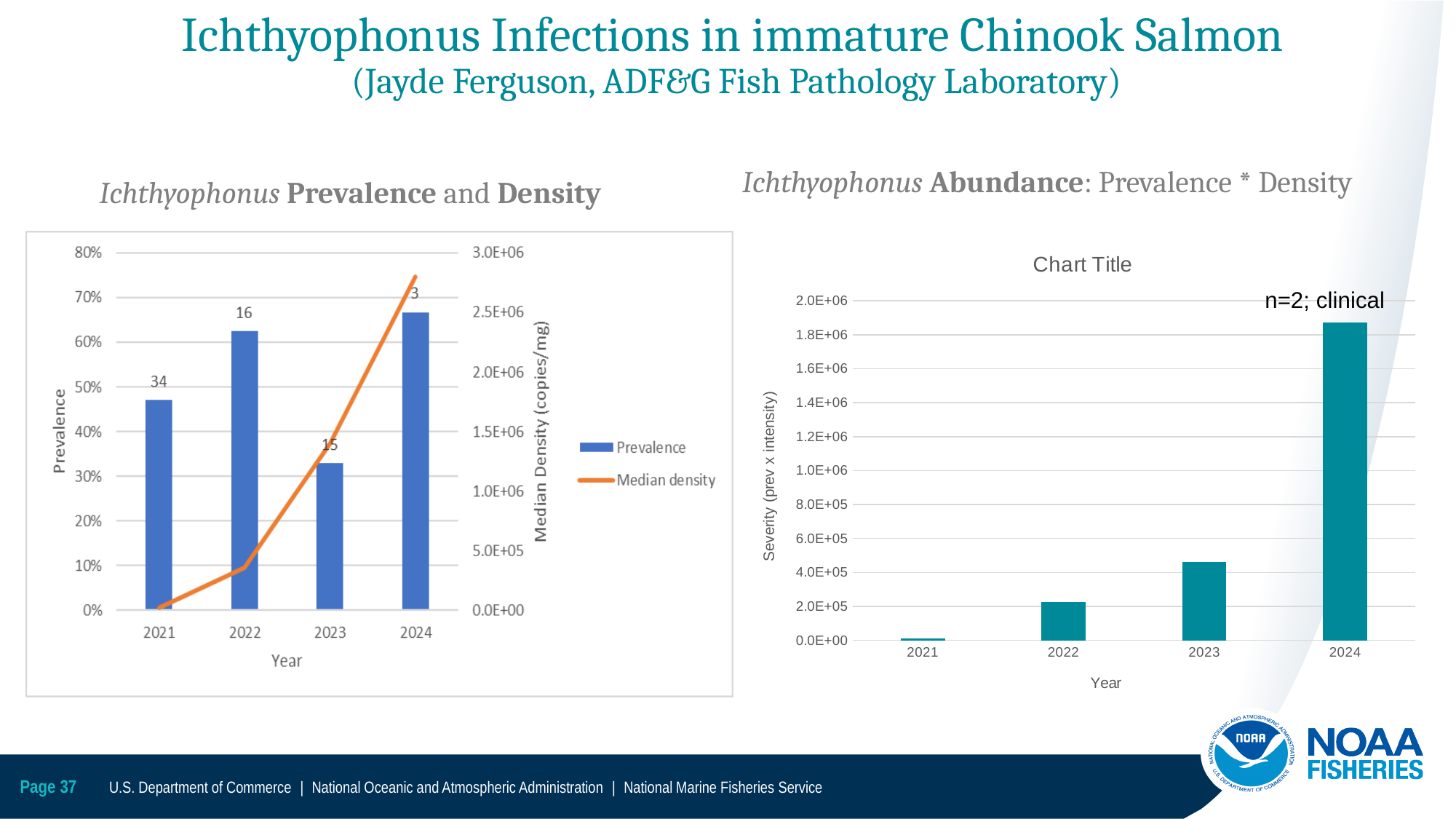
On the left chart, does the median density rise or fall from 2021 to 2024? rises On the right chart (Severity by Year), which year has the highest severity? 2024 What are the two legend entries on the left chart? Prevalence and Median density On the left chart, how many years are shown on the x axis? 4 On the left chart, is the prevalence for 2021 greater or less than 40%? greater On the left chart, is the prevalence for 2023 greater or less than 40%? less On the right chart (Severity by Year), what annotation text appears above the 2024 bar? n=2; clinical What kind of chart is the left chart, titled 'Ichthyophonus Prevalence and Density'? A bar chart with a line series How many series does the legend of the left chart list? 2 On the left chart, which year has the lowest prevalence? 2023 On the right chart (Severity by Year), which year has the lowest severity? 2021 On the right chart (Severity by Year), is the value for 2023 greater or less than 6.0E+05? less